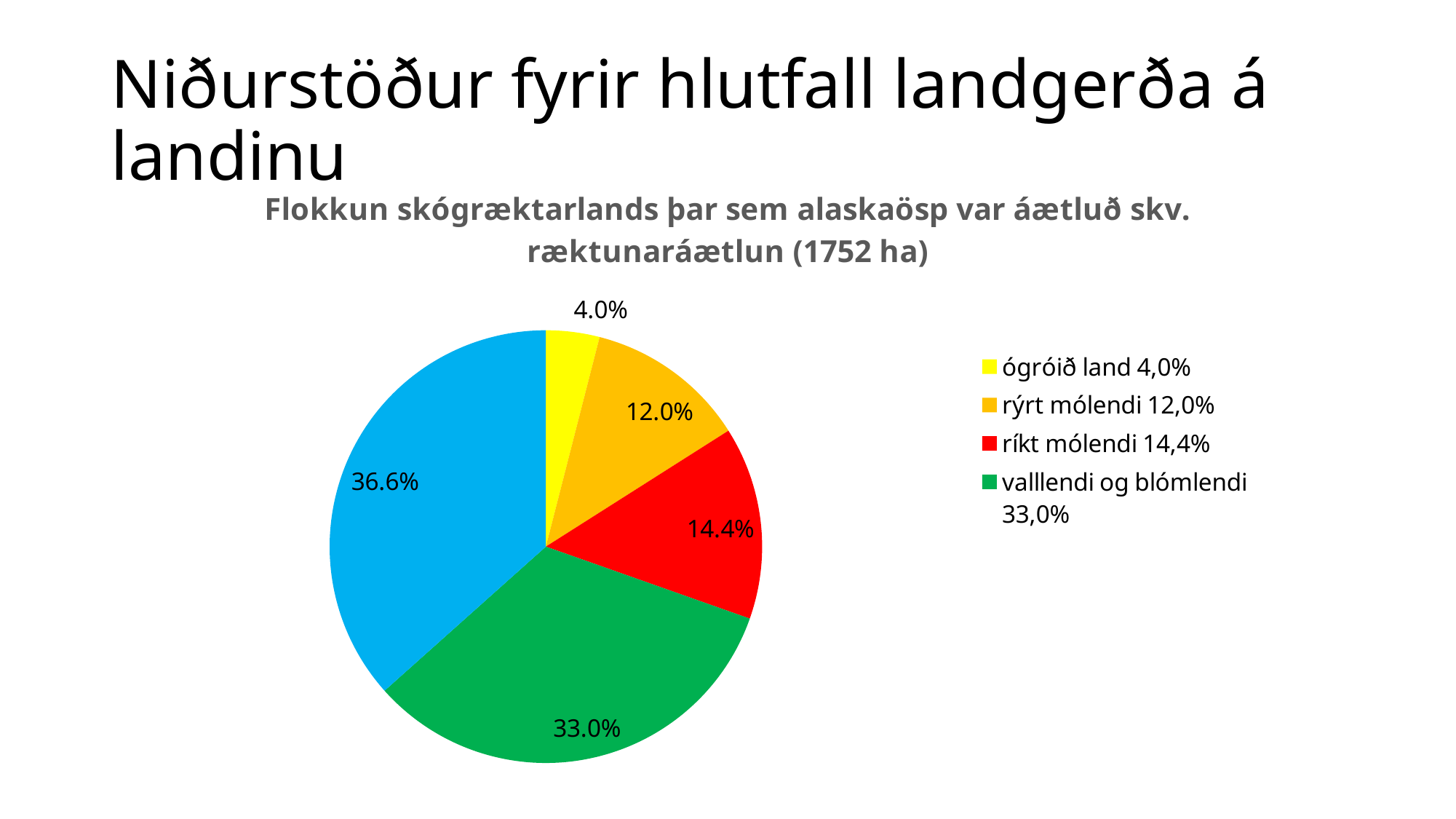
What is the difference between the ríkt mólendi slice and the rýrt mólendi slice? 2.4% Which is larger, the slice for ríkt mólendi or the slice for rýrt mólendi? ríkt mólendi What colour is the slice labelled 36.6%? blue What is the value shown for ríkt mólendi? 14.4% What share of the pie does valllendi og blómlendi take? 33.0% How many slices does the pie chart have? 5 How many entries does the legend list? 4 What is the value printed on the largest slice of the pie? 36.6% What kind of chart is shown on the slide? pie chart What share of the pie does ógróið land take? 4.0% What is the value shown for rýrt mólendi? 12.0% Which of the legend categories has the smallest slice? ógróið land